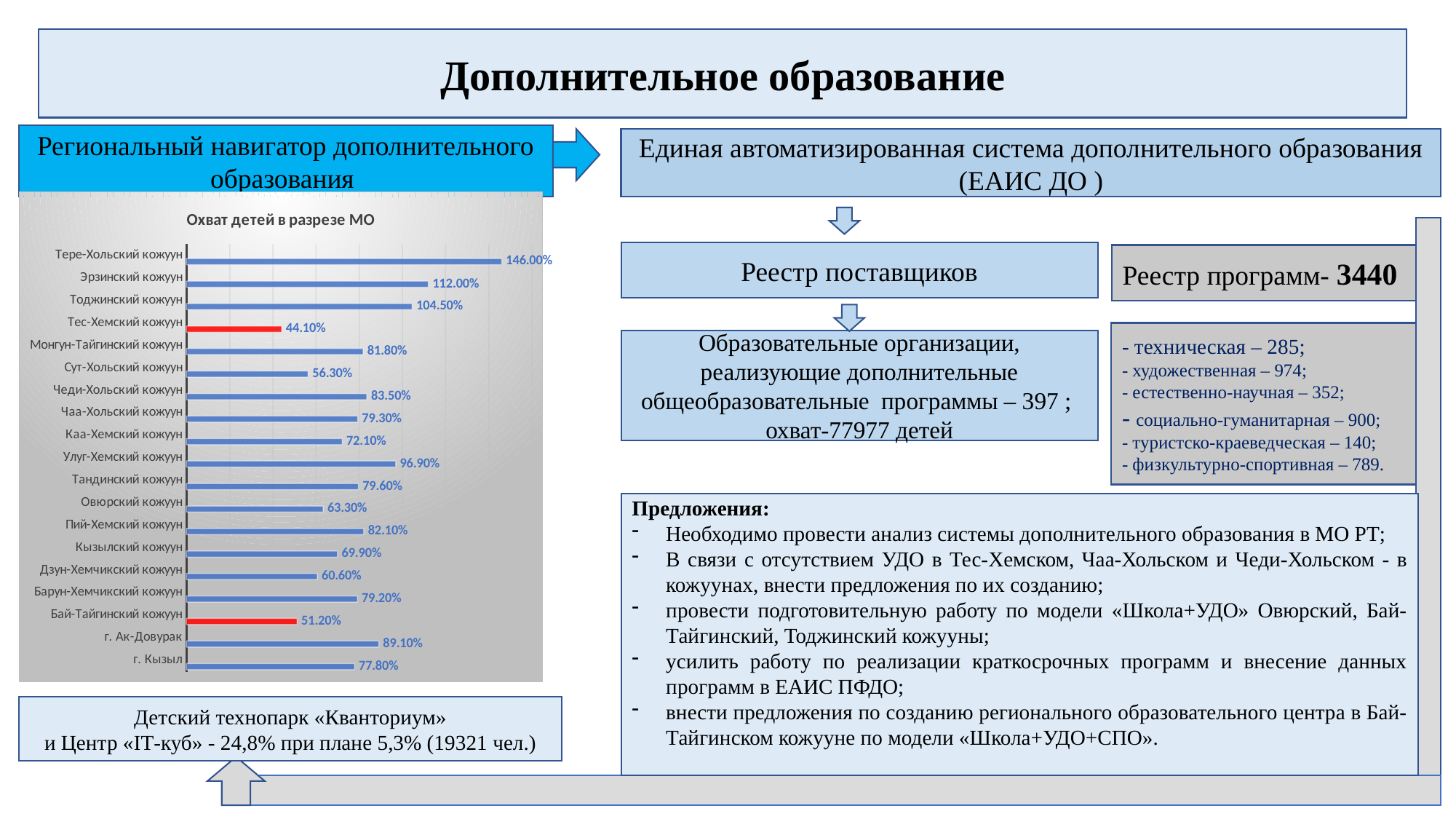
Which category has the highest value? Тере-Хольский кожуун What is the value for Тере-Хольский кожуун? 146.00% What is the value for г. Кызыл? 77.80% What kind of chart is shown on the slide? Bar chart What is the value for Улуг-Хемский кожуун? 96.90% How many categories are shown in the chart? 19 Which is larger, the value for г. Ак-Довурак or the value for Пий-Хемский кожуун? г. Ак-Довурак Which two categories have bars coloured red? Тес-Хемский кожуун and Бай-Тайгинский кожуун What is the title of the chart? Охват детей в разрезе МО Which category has the lowest value? Тес-Хемский кожуун What is the difference between the values for Тере-Хольский кожуун and Тес-Хемский кожуун? 101.90% What is the difference between the values for Эрзинский кожуун and Тоджинский кожуун? 7.50%